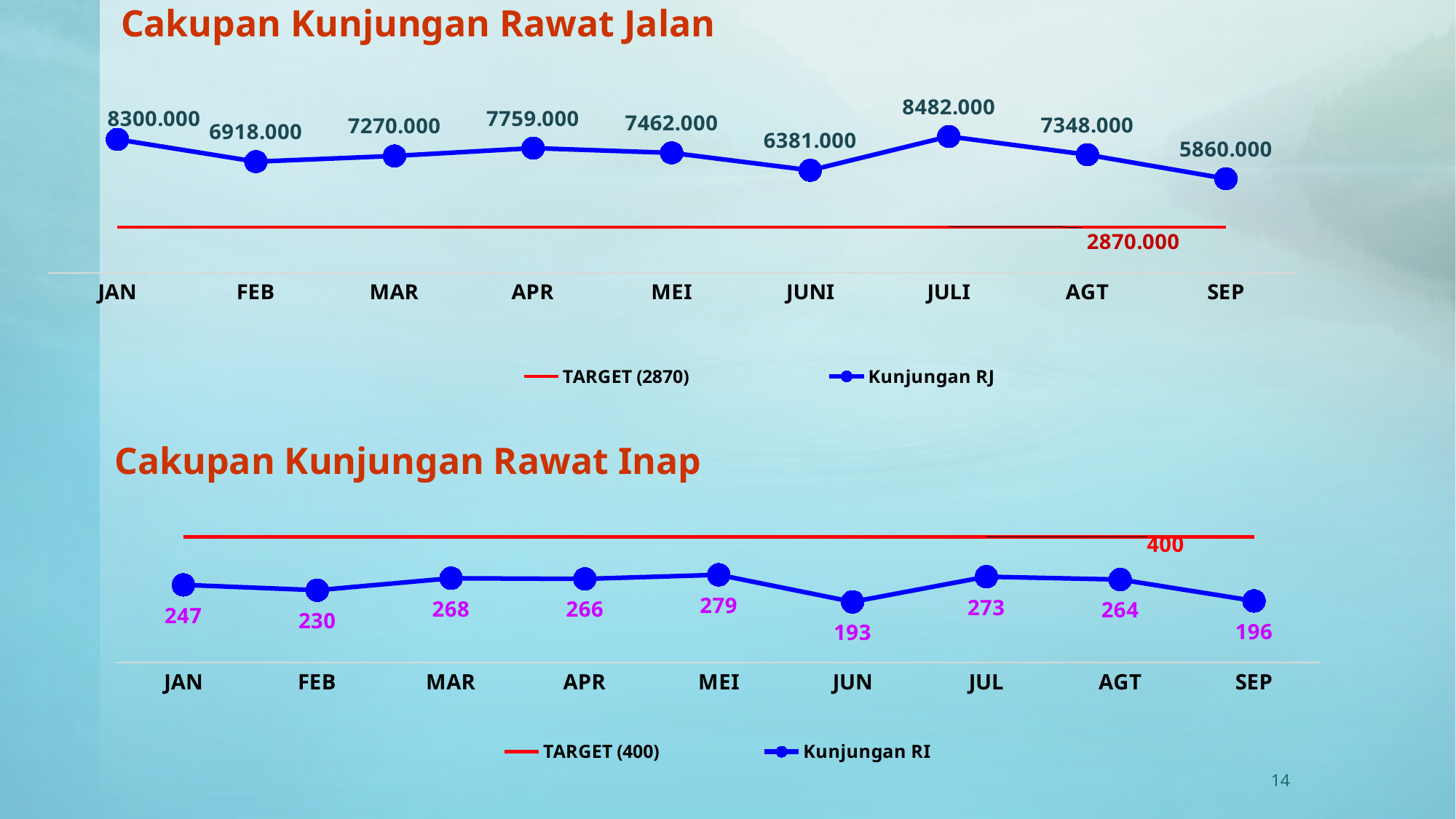
In the 'Cakupan Kunjungan Rawat Jalan' chart, which month has the lowest Kunjungan RJ value? SEP What kind of chart is 'Cakupan Kunjungan Rawat Inap'? Line chart In the 'Cakupan Kunjungan Rawat Inap' chart, which is larger, the value for MAR or the value for AGT? MAR In the 'Cakupan Kunjungan Rawat Inap' chart, which month has the lowest Kunjungan RI value? JUN In the 'Cakupan Kunjungan Rawat Jalan' chart, which month has the highest Kunjungan RJ value? JULI In the 'Cakupan Kunjungan Rawat Jalan' chart, how many series does the legend list? 2 In the 'Cakupan Kunjungan Rawat Jalan' chart, what target value is shown on the red line? 2870.000 In the 'Cakupan Kunjungan Rawat Jalan' chart, what is the difference between the JAN value and the FEB value? 1382.000 In the 'Cakupan Kunjungan Rawat Jalan' chart, what is the value for JULI? 8482.000 In the 'Cakupan Kunjungan Rawat Inap' chart, what is the difference between the JUL value and the SEP value? 77 In the 'Cakupan Kunjungan Rawat Inap' chart, how many months are plotted on the x axis? 9 In the 'Cakupan Kunjungan Rawat Inap' chart, what is the value for MEI? 279